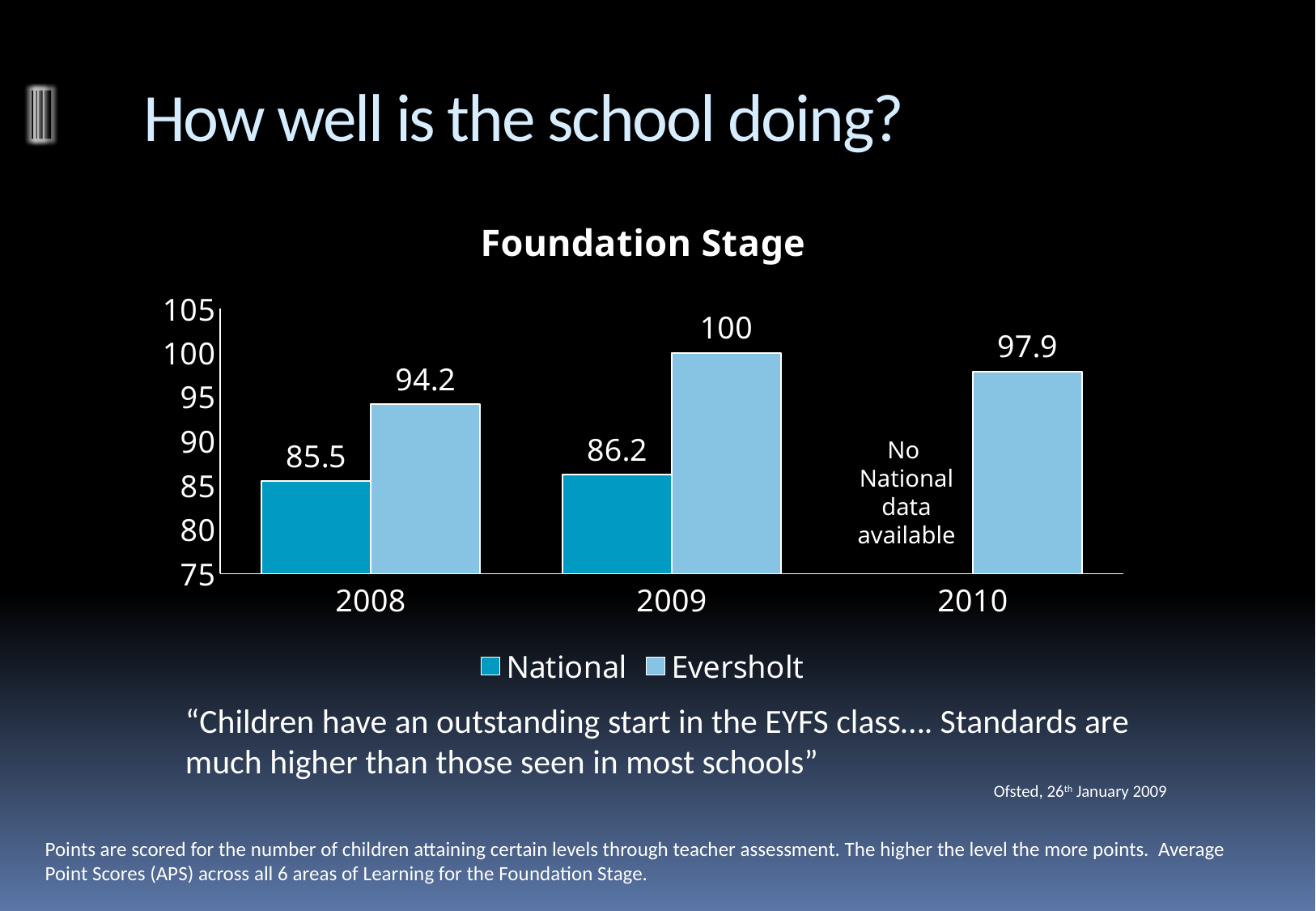
In which year is the Eversholt value lowest? 2008 How many years are shown on the x axis? 3 What is the National value for 2008? 85.5 Which is larger in 2008, the National value or the Eversholt value? Eversholt What is the Eversholt value for 2010? 97.9 What is the Eversholt value for 2008? 94.2 What is the difference between the Eversholt and National values in 2009? 13.8 What is the National value for 2009? 86.2 In which year is the Eversholt value highest? 2009 What is the title of the chart? Foundation Stage What kind of chart is shown? Bar chart How many series does the legend list? 2